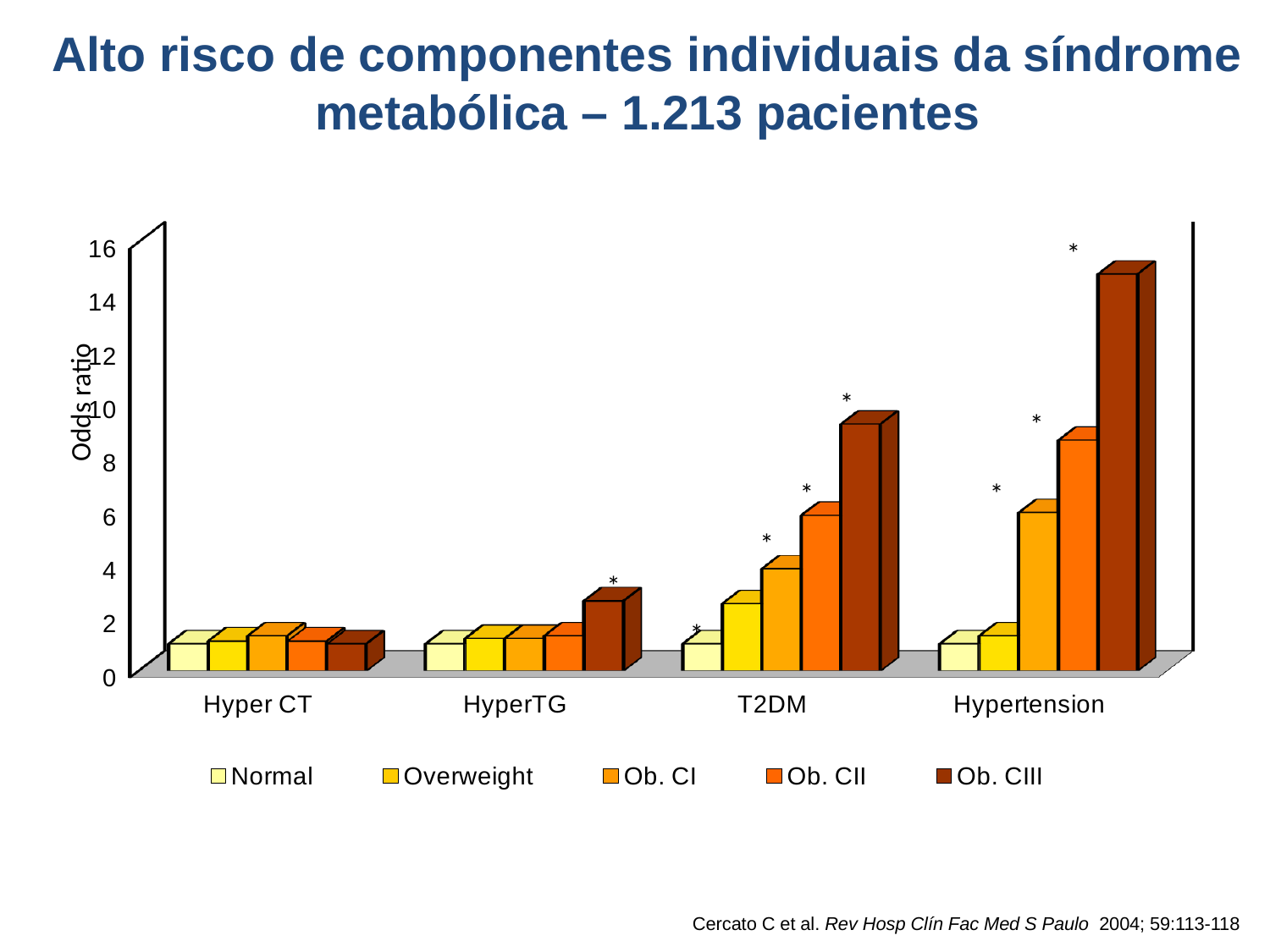
In which category is the Ob. CIII bar the highest? Hypertension Which series is listed last in the legend? Ob. CIII Is the value for Ob. CIII in the T2DM category greater or less than 8? greater Is the value for Normal in the Hyper CT category greater or less than 2? less Is the value for Ob. CIII in the HyperTG category greater or less than 4? less What kind of chart is shown on the slide? bar chart Which is larger, the Ob. CIII value for Hypertension or the Ob. CIII value for T2DM? Hypertension What is the label of the y axis? Odds ratio How many series does the legend list? 5 How many categories are shown on the x axis of the chart? 4 Which series has the highest bar in the T2DM category? Ob. CIII